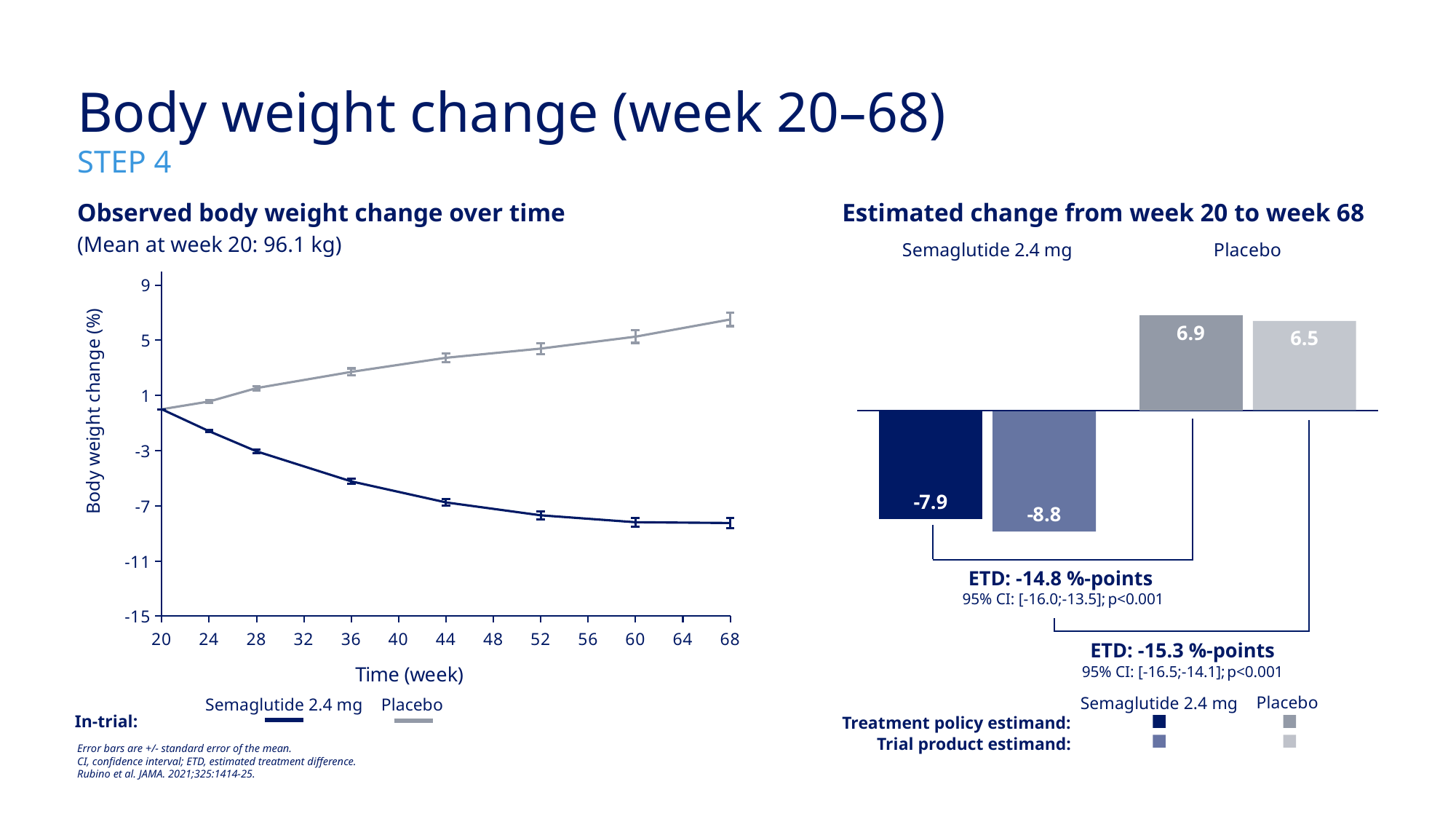
On the 'Estimated change from week 20 to week 68' chart, what is the treatment policy estimand value for Semaglutide 2.4 mg? -7.9 On the 'Observed body weight change over time' chart, is the Semaglutide 2.4 mg value at week 68 greater or less than -7? less On the 'Estimated change from week 20 to week 68' chart, which bar has the highest value? Placebo treatment policy estimand (6.9) On the 'Observed body weight change over time' chart, does the Semaglutide 2.4 mg line rise or fall from week 20 to week 68? Fall On the 'Estimated change from week 20 to week 68' chart, what is the difference between the Placebo treatment policy estimand (6.9) and the Placebo trial product estimand (6.5)? 0.4 On the 'Observed body weight change over time' chart, is the Placebo value at week 68 greater or less than 5? greater On the 'Estimated change from week 20 to week 68' chart, what is the trial product estimand value for Placebo? 6.5 On the 'Observed body weight change over time' chart, how many series does the legend list? 2 On the 'Estimated change from week 20 to week 68' chart, what is the trial product estimand value for Semaglutide 2.4 mg? -8.8 What kind of chart is 'Observed body weight change over time'? Line chart On the 'Estimated change from week 20 to week 68' chart, which bar has the lowest value? Semaglutide 2.4 mg trial product estimand (-8.8) What kind of chart is 'Estimated change from week 20 to week 68'? Bar chart